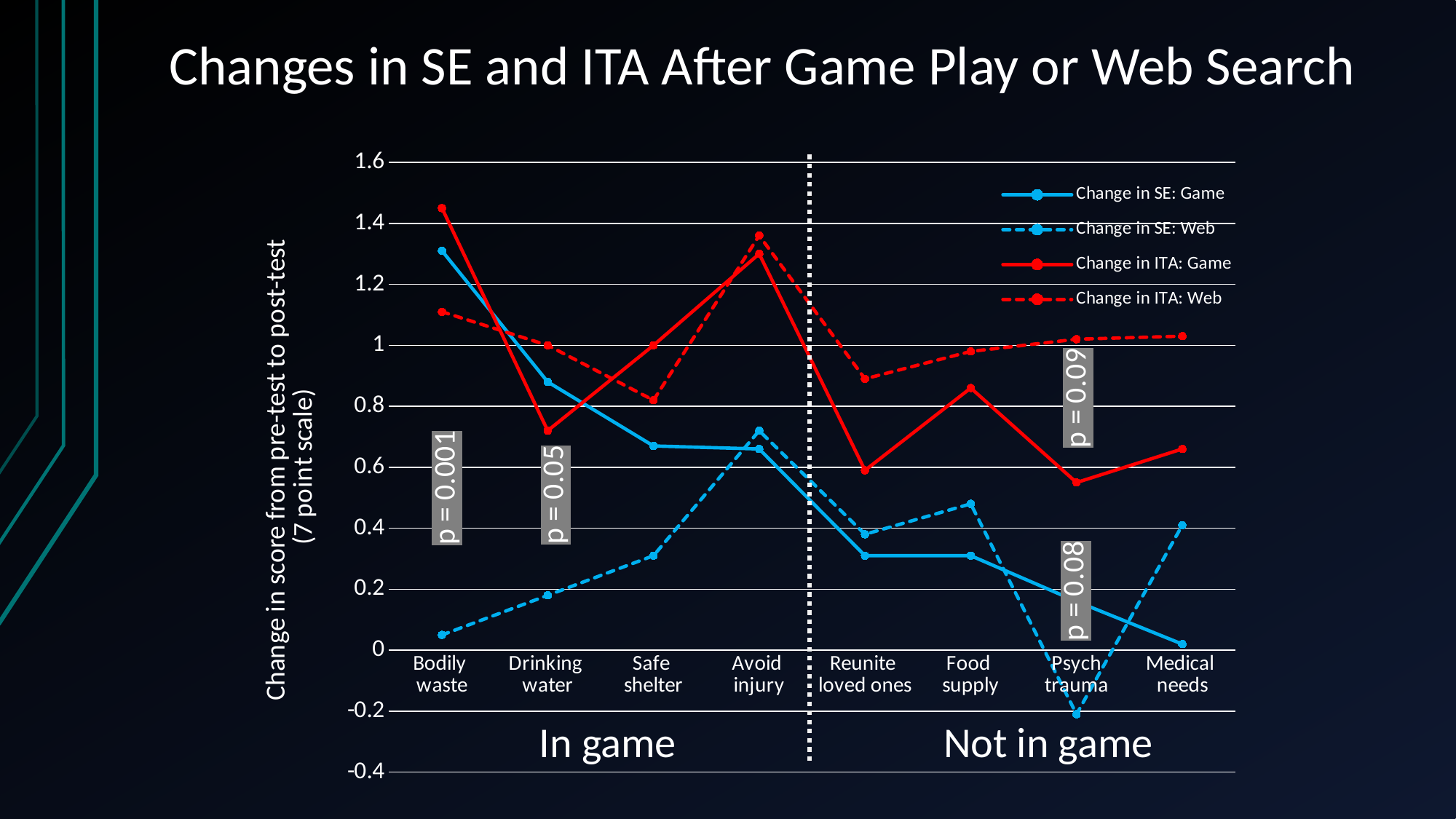
Which category has the highest value for Change in ITA: Game? Bodily waste How many series does the legend list? 4 How many categories are shown along the x axis? 8 Is the value for Change in ITA: Game at Bodily waste greater or less than 1.2? greater Which category has the highest value for Change in SE: Game? Bodily waste Which category has the lowest value for Change in SE: Web? Psych trauma What p-value label is shown near the Bodily waste category? p = 0.001 What kind of chart is shown on the slide? line chart At Medical needs, which is larger: Change in ITA: Web or Change in ITA: Game? Change in ITA: Web Does the Change in SE: Web series rise or fall from Bodily waste to Avoid injury? rise Is the value for Change in SE: Web at Bodily waste greater or less than 0.2? less Is the value for Change in SE: Web at Psych trauma greater or less than 0? less